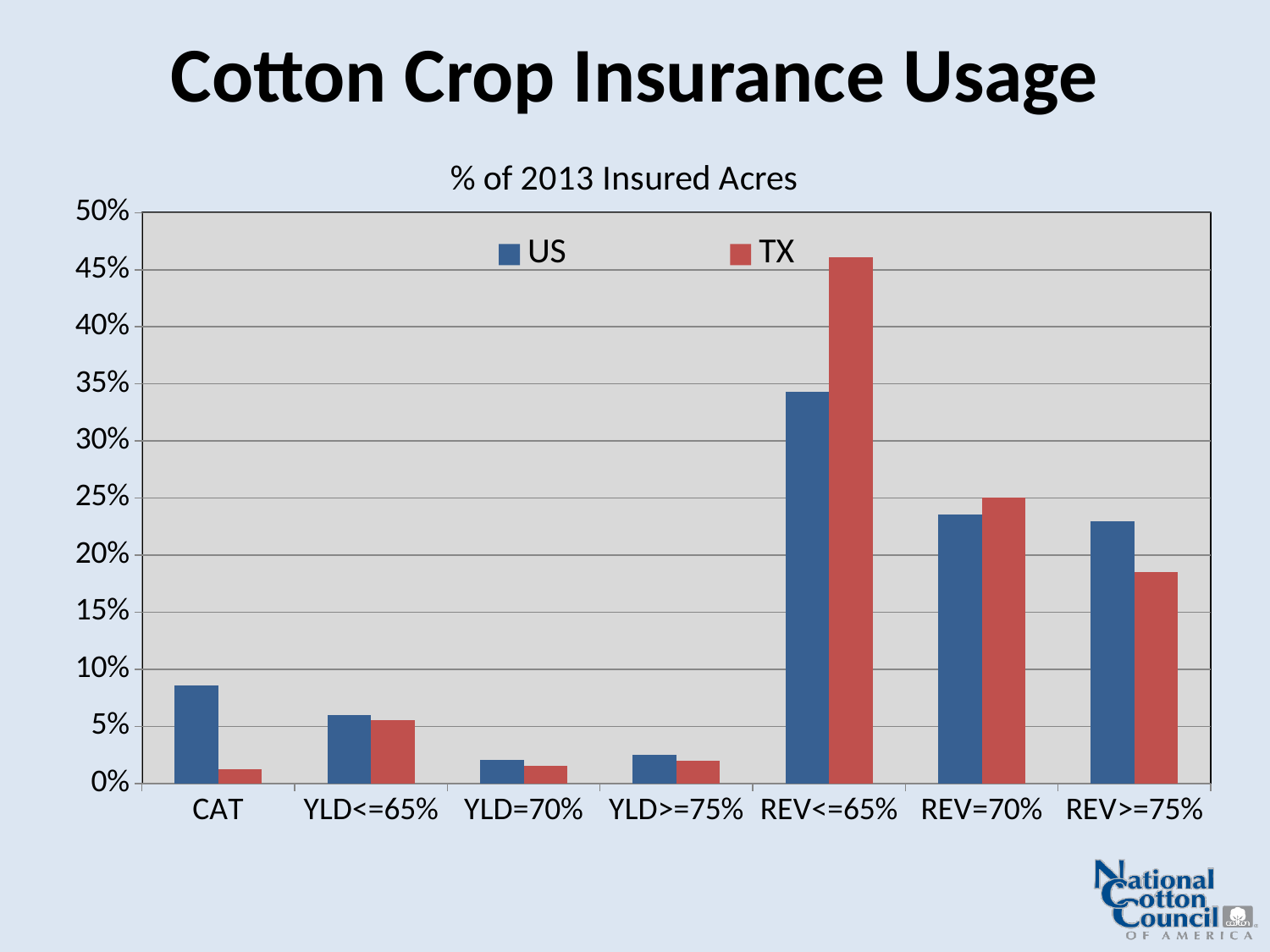
What kind of chart is shown on the slide? Bar chart Is the TX value for REV>=75% greater or less than 20%? less What is the subtitle shown above the chart? % of 2013 Insured Acres Is the TX value for REV<=65% greater or less than 40%? greater For REV>=75%, which series has the larger value, US or TX? US How many series does the legend list? 2 Which category has the highest value for the TX series? REV<=65% For REV<=65%, which series has the larger value, US or TX? TX For CAT, which series has the larger value, US or TX? US Is the US value for CAT greater or less than 10%? less Which category has the highest value for the US series? REV<=65% How many categories are shown on the x axis? 7